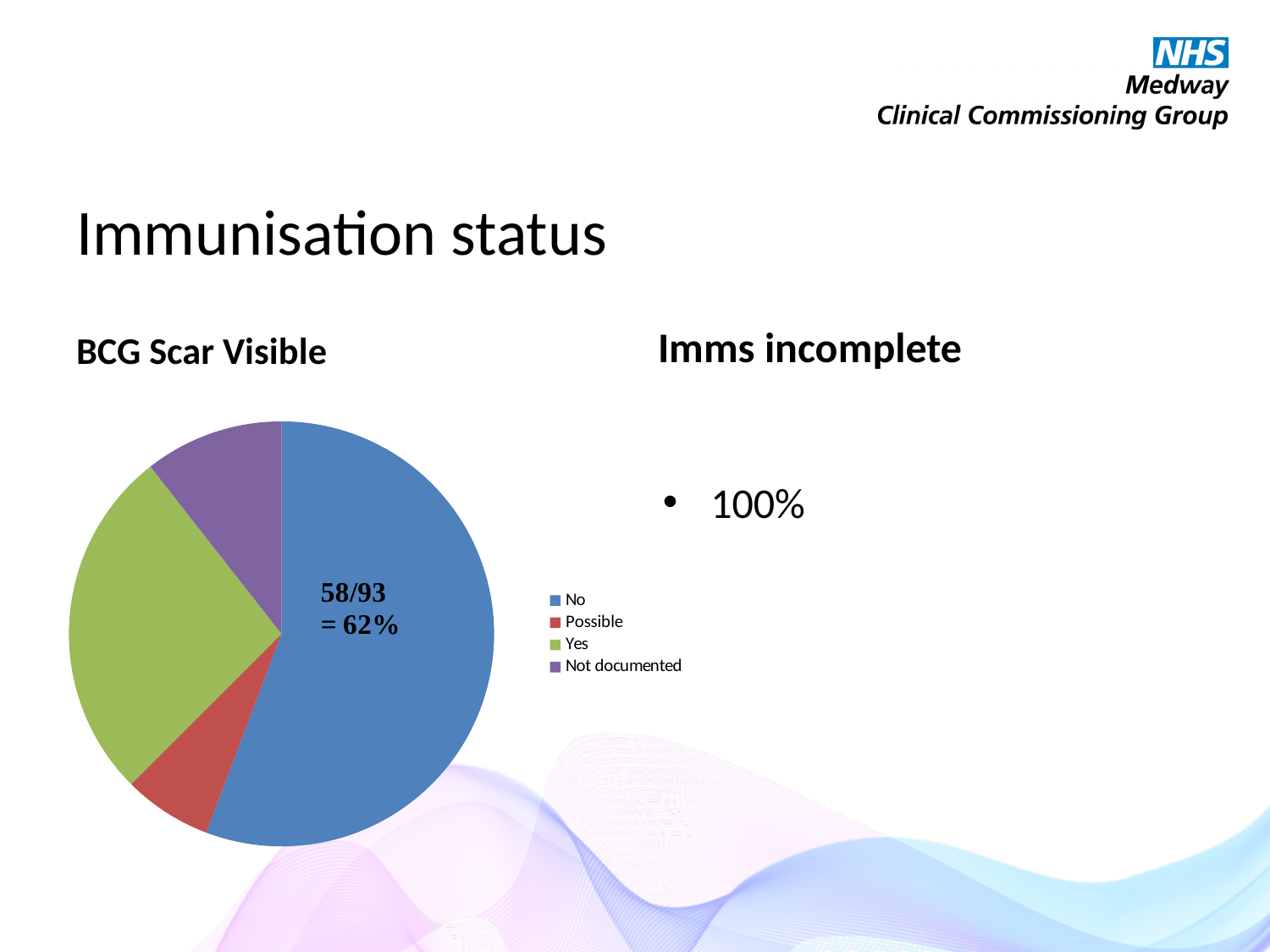
What kind of chart is shown under the heading "BCG Scar Visible"? Pie chart In the BCG Scar Visible pie chart, which slice is larger: "No" or "Yes"? No What is the title of the pie chart on the slide? BCG Scar Visible Which category has the largest slice in the BCG Scar Visible pie chart? No Which category has the smallest slice in the BCG Scar Visible pie chart? Possible How many categories does the legend of the BCG Scar Visible pie chart list? 4 What label is printed on the "No" slice of the BCG Scar Visible pie chart? 58/93 = 62% What share of the BCG Scar Visible pie does the "No" slice represent? 62% Which colour represents the "Yes" category in the BCG Scar Visible pie chart? Green In the BCG Scar Visible pie chart, which slice is larger: "Yes" or "Not documented"? Yes In the BCG Scar Visible pie chart, which slice is larger: "Not documented" or "Possible"? Not documented